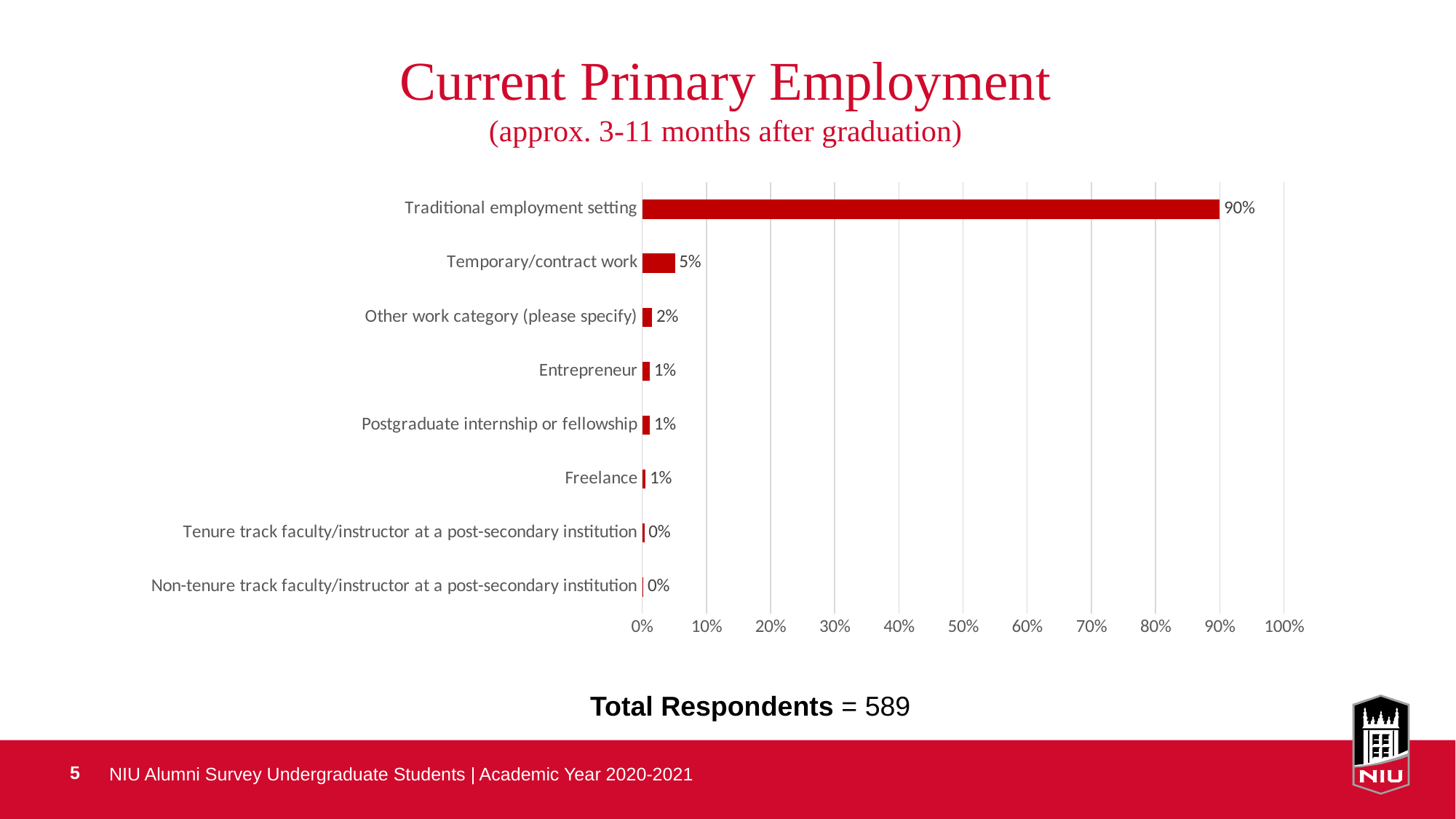
What kind of chart is shown on the slide? Bar chart What is the value for Tenure track faculty/instructor at a post-secondary institution? 0% Which is larger, Temporary/contract work or Freelance? Temporary/contract work Which category has the highest value? Traditional employment setting What is the difference between Temporary/contract work and Other work category (please specify)? 3% What percentage of respondents are in a traditional employment setting? 90% How many categories are shown in the chart? 8 What is the value for Other work category (please specify)? 2% What is the value for Temporary/contract work? 5% What is the difference between Traditional employment setting and Temporary/contract work? 85% What is the value for Entrepreneur? 1% What is the total number of respondents stated on the slide? 589